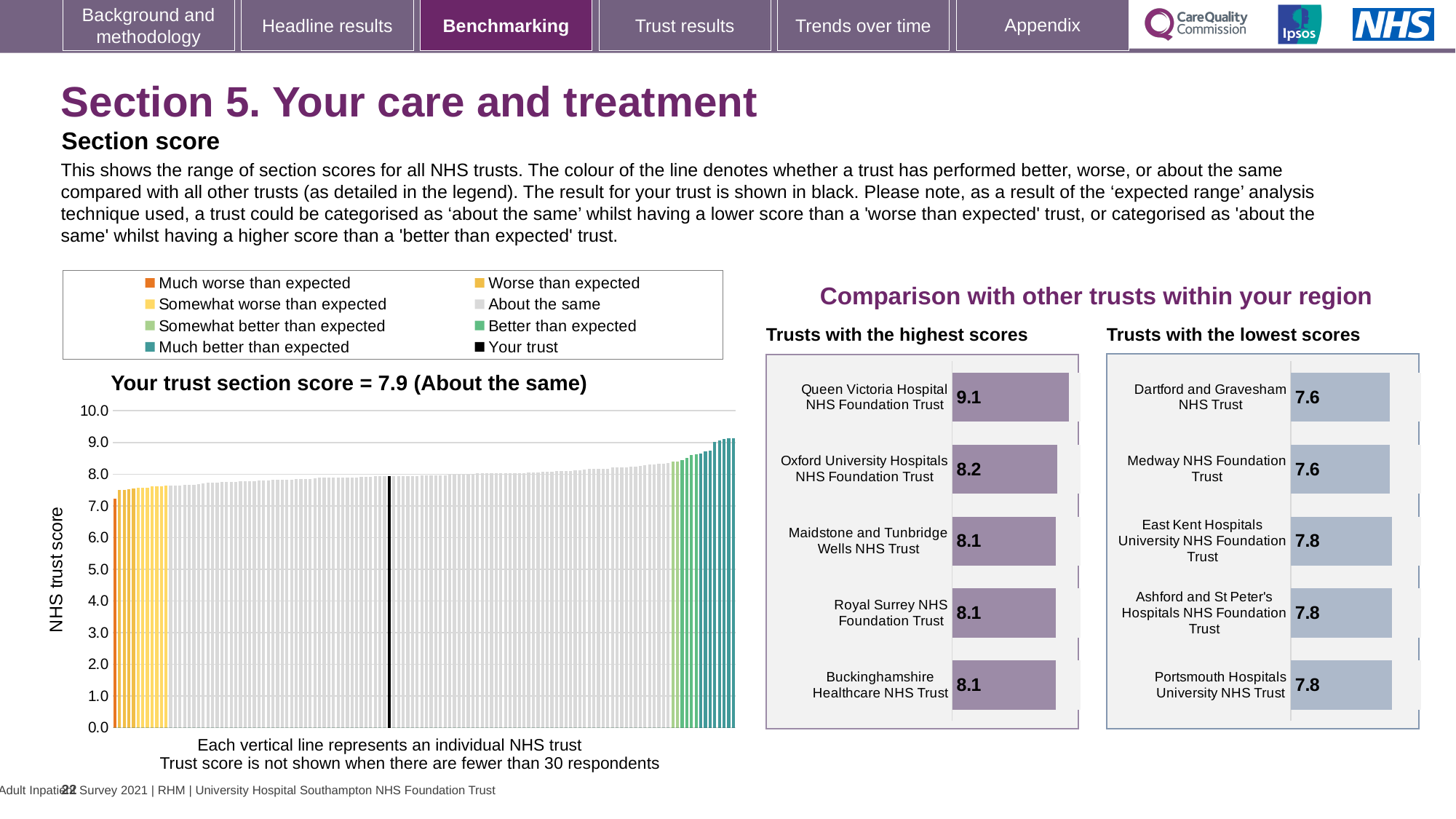
On the 'Your trust section score' chart, what kind of chart is shown? bar chart On the 'Trusts with the highest scores' chart, which trust has the highest score? Queen Victoria Hospital NHS Foundation Trust On the 'Trusts with the lowest scores' chart, what is the difference between the scores of East Kent Hospitals University NHS Foundation Trust and Dartford and Gravesham NHS Trust? 0.2 On the 'Your trust section score' chart, is your trust's score greater or less than 8.0? less On the 'Trusts with the highest scores' chart, what is the score for Queen Victoria Hospital NHS Foundation Trust? 9.1 On the 'Trusts with the highest scores' chart, how many trusts are shown? 5 On the 'Trusts with the lowest scores' chart, which is larger, the score for Portsmouth Hospitals University NHS Trust or Dartford and Gravesham NHS Trust? Portsmouth Hospitals University NHS Trust On the 'Trusts with the lowest scores' chart, what is the score for Medway NHS Foundation Trust? 7.6 On the 'Your trust section score' chart, how many entries does the legend list? 8 On the 'Your trust section score' chart, what is the label on the vertical axis? NHS trust score On the 'Trusts with the highest scores' chart, what is the difference between the scores of Queen Victoria Hospital NHS Foundation Trust and Oxford University Hospitals NHS Foundation Trust? 0.9 On the 'Your trust section score' chart, what is the section score for your trust? 7.9